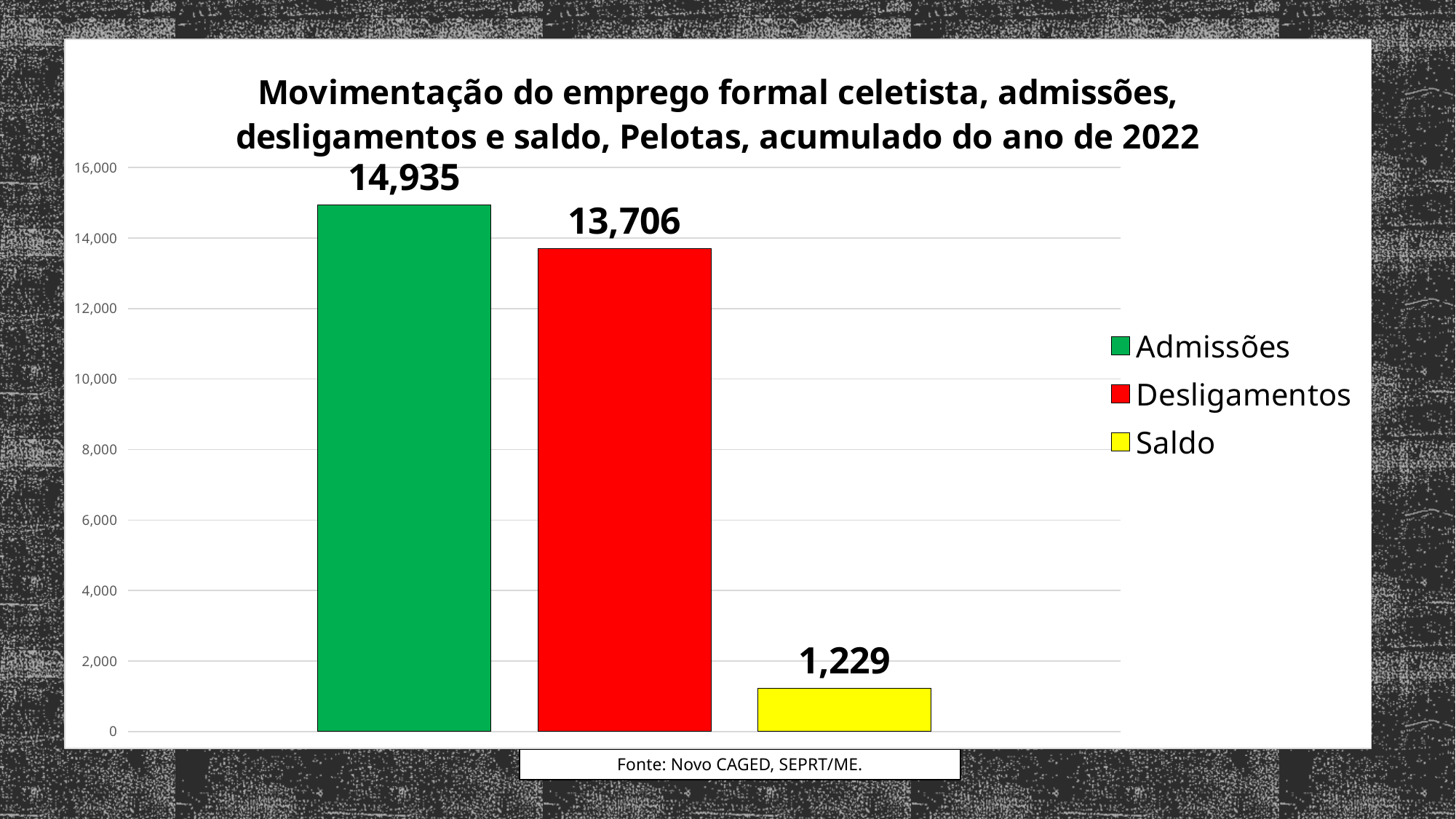
Which is larger, Desligamentos or Saldo? Desligamentos What colour is the bar for Saldo? yellow What is the value for Admissões? 14,935 What is the value for Saldo? 1,229 What is the value for Desligamentos? 13,706 How many series does the legend list? 3 Which series has the highest value? Admissões Is the value for Desligamentos greater or less than 14,000? less Which series has the lowest value? Saldo What kind of chart is shown on the slide? bar chart How many bars are plotted in the chart? 3 What is the difference between Admissões and Desligamentos? 1,229